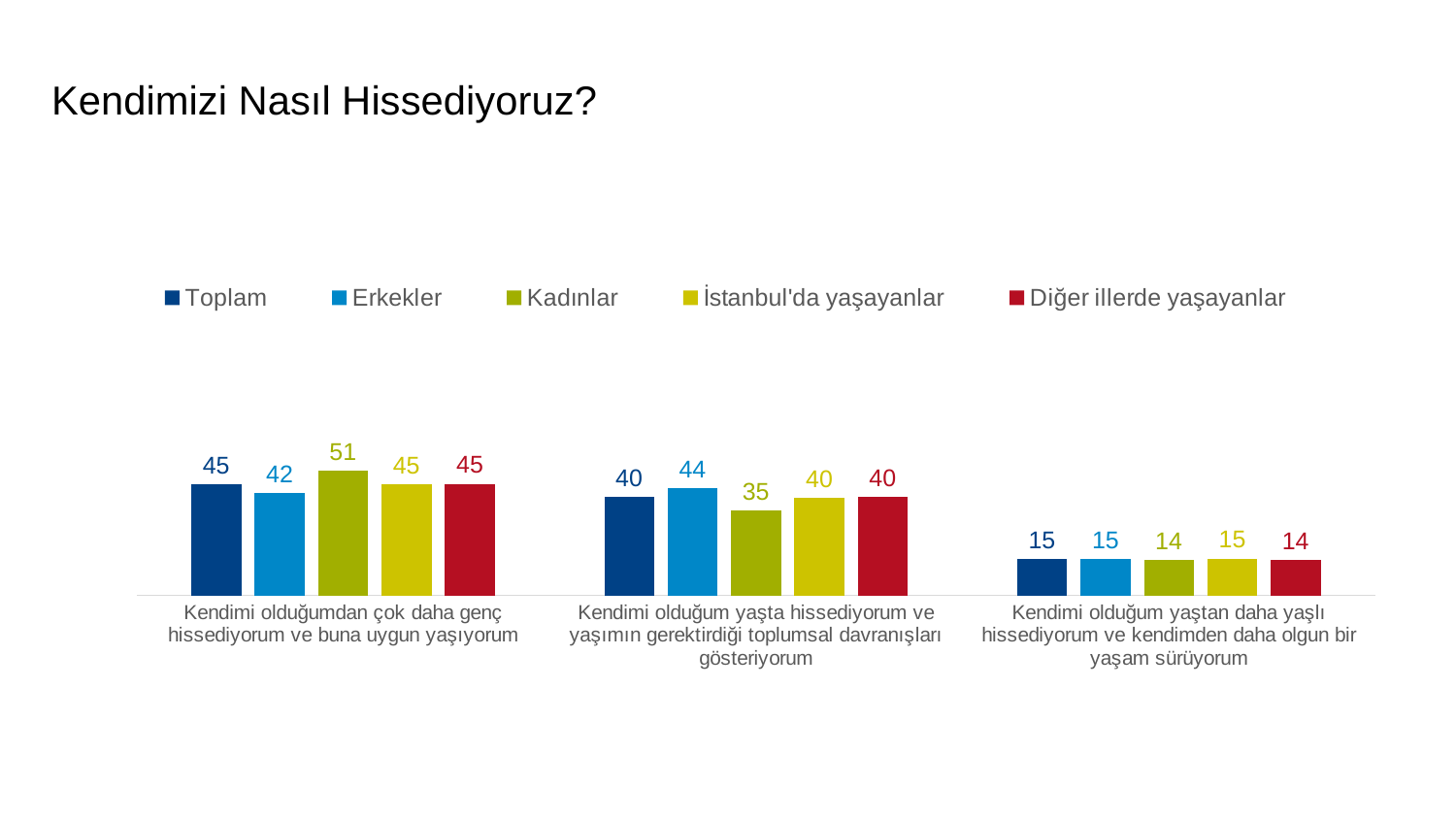
What is the title of the slide? Kendimizi Nasıl Hissediyoruz? What is the difference between the Kadınlar and Erkekler values in the category "Kendimi olduğumdan çok daha genç hissediyorum ve buna uygun yaşıyorum"? 9 What is the value for Erkekler in the category "Kendimi olduğum yaşta hissediyorum ve yaşımın gerektirdiği toplumsal davranışları gösteriyorum"? 44 Which series has the lowest value in the category "Kendimi olduğum yaşta hissediyorum ve yaşımın gerektirdiği toplumsal davranışları gösteriyorum"? Kadınlar How many categories are shown on the x axis? 3 What is the value for Kadınlar in the category "Kendimi olduğumdan çok daha genç hissediyorum ve buna uygun yaşıyorum"? 51 What kind of chart is shown on the slide? Bar chart What is the value for Diğer illerde yaşayanlar in the category "Kendimi olduğum yaştan daha yaşlı hissediyorum ve kendimden daha olgun bir yaşam sürüyorum"? 14 Which is larger: the Toplam value for "Kendimi olduğumdan çok daha genç hissediyorum ve buna uygun yaşıyorum" or the Toplam value for "Kendimi olduğum yaşta hissediyorum ve yaşımın gerektirdiği toplumsal davranışları gösteriyorum"? Kendimi olduğumdan çok daha genç hissediyorum ve buna uygun yaşıyorum What is the difference between the Erkekler and Kadınlar values in the category "Kendimi olduğum yaşta hissediyorum ve yaşımın gerektirdiği toplumsal davranışları gösteriyorum"? 9 How many series does the legend list? 5 Which series has the highest value in the category "Kendimi olduğumdan çok daha genç hissediyorum ve buna uygun yaşıyorum"? Kadınlar